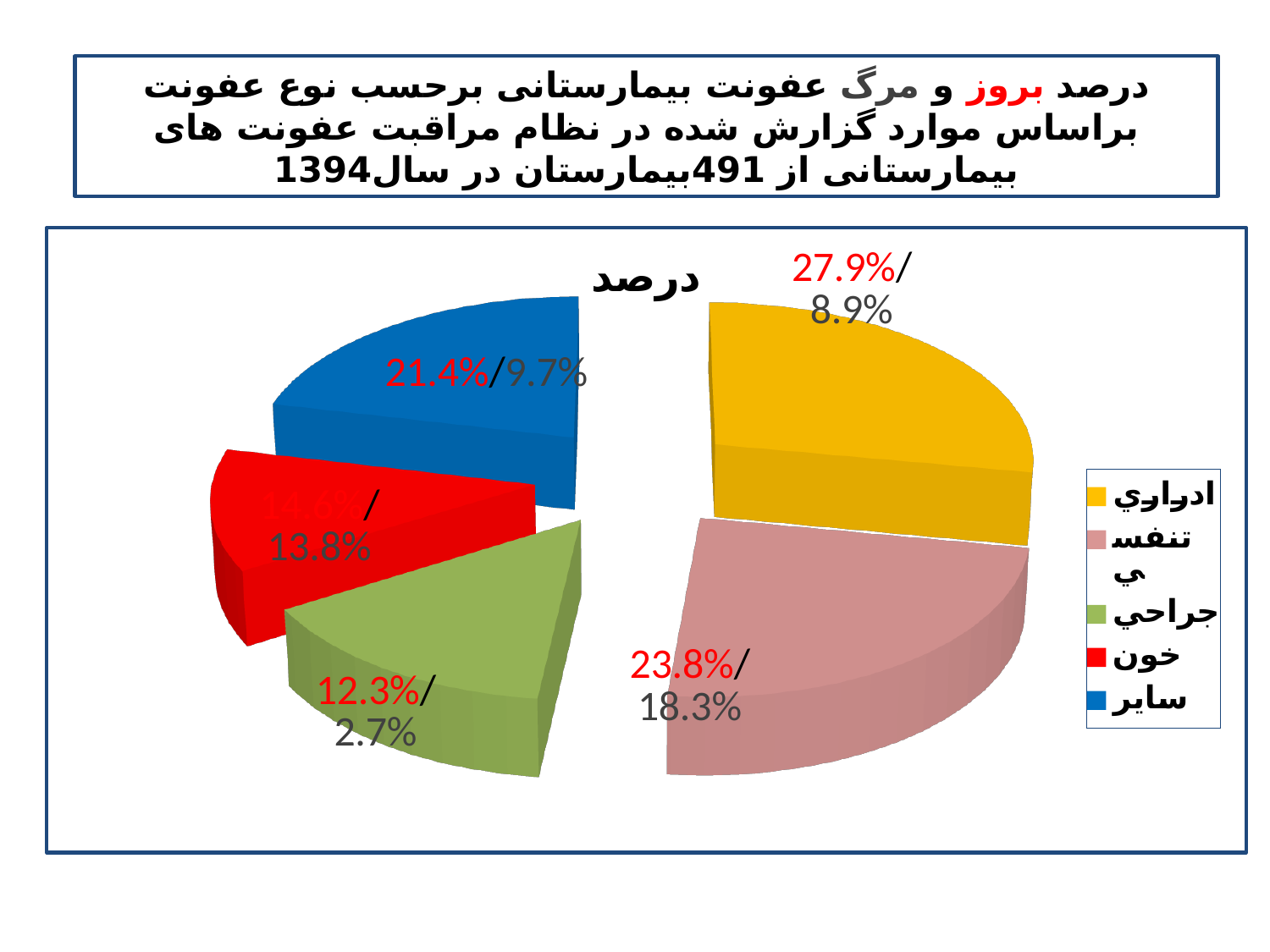
What is the incidence (بروز) percentage shown in red for the ادراري slice? 27.9% What is the incidence (بروز) percentage shown in red for the جراحي slice? 12.3% What is the difference between the incidence percentages of ادراري (27.9%) and تنفسي (23.8%)? 4.1% Which infection type has the highest incidence (بروز) percentage? ادراري What is the death (مرگ) percentage shown in black for the تنفسي slice? 18.3% How many entries does the legend list? 5 What kind of chart is shown on the slide? Pie chart What is the incidence (بروز) percentage shown in red for the ساير slice? 21.4% What is the death (مرگ) percentage shown in black for the خون slice? 13.8% Which colour represents the خون slice in the legend? Red How many slices does the pie chart have? 5 Which infection type has the lowest death (مرگ) percentage? جراحي